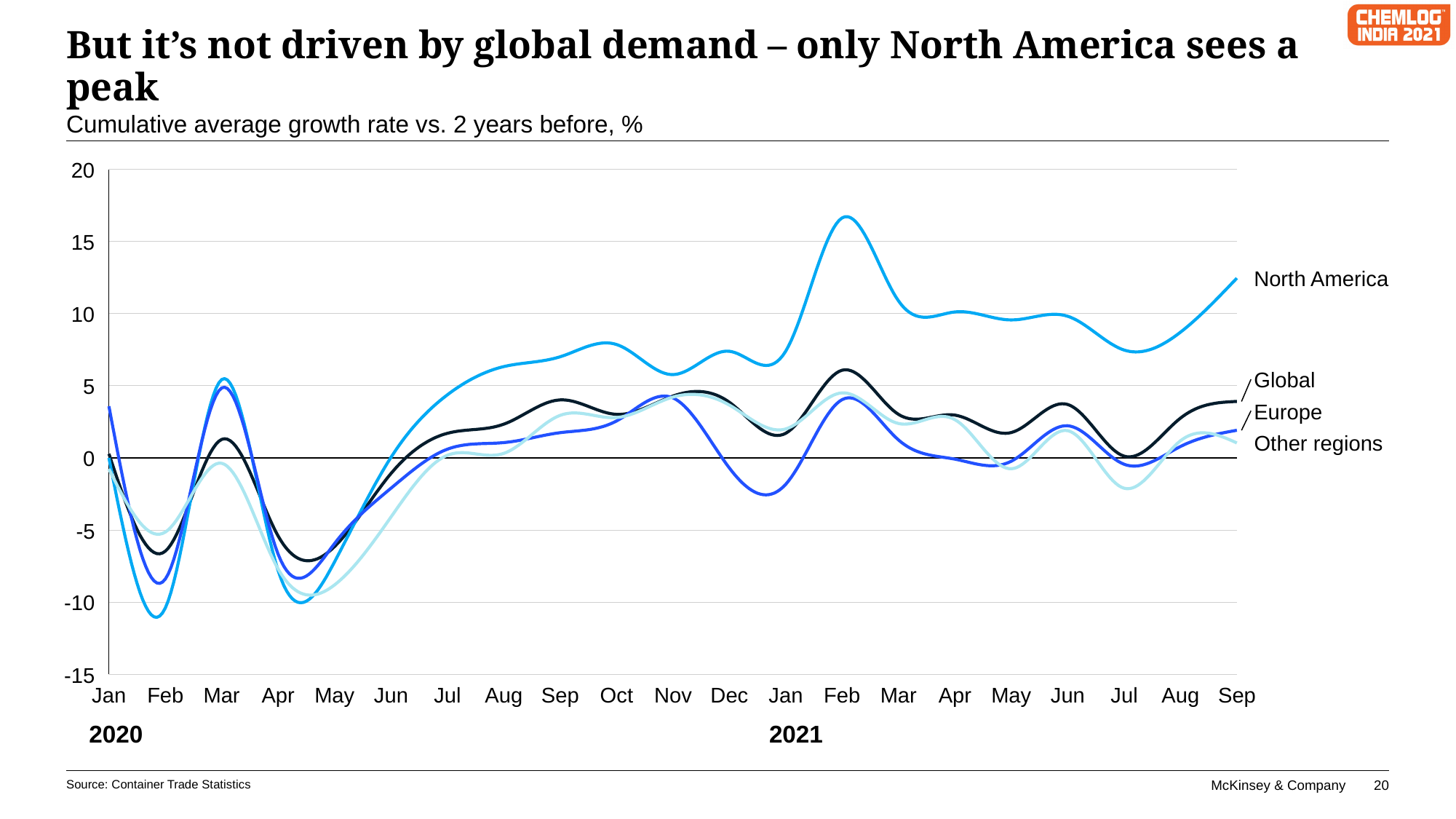
Is the value for North America in Sep 2021 greater or less than 10? greater How many series are plotted on the chart? 4 How many monthly points are shown along the x axis of the chart? 21 Is the value for North America in Feb 2021 greater or less than 15? greater Does the North America line rise or fall between Jul 2021 and Sep 2021? Rise What metric does the chart subtitle say is plotted? Cumulative average growth rate vs. 2 years before, % What kind of chart is shown on the slide? Line chart Which series has the lowest value in Feb 2020? North America Is the value for Europe in Jan 2021 greater or less than 0? less Which series reaches the highest value on the chart? North America In Feb 2021, which is larger: the value for North America or the value for Global? North America